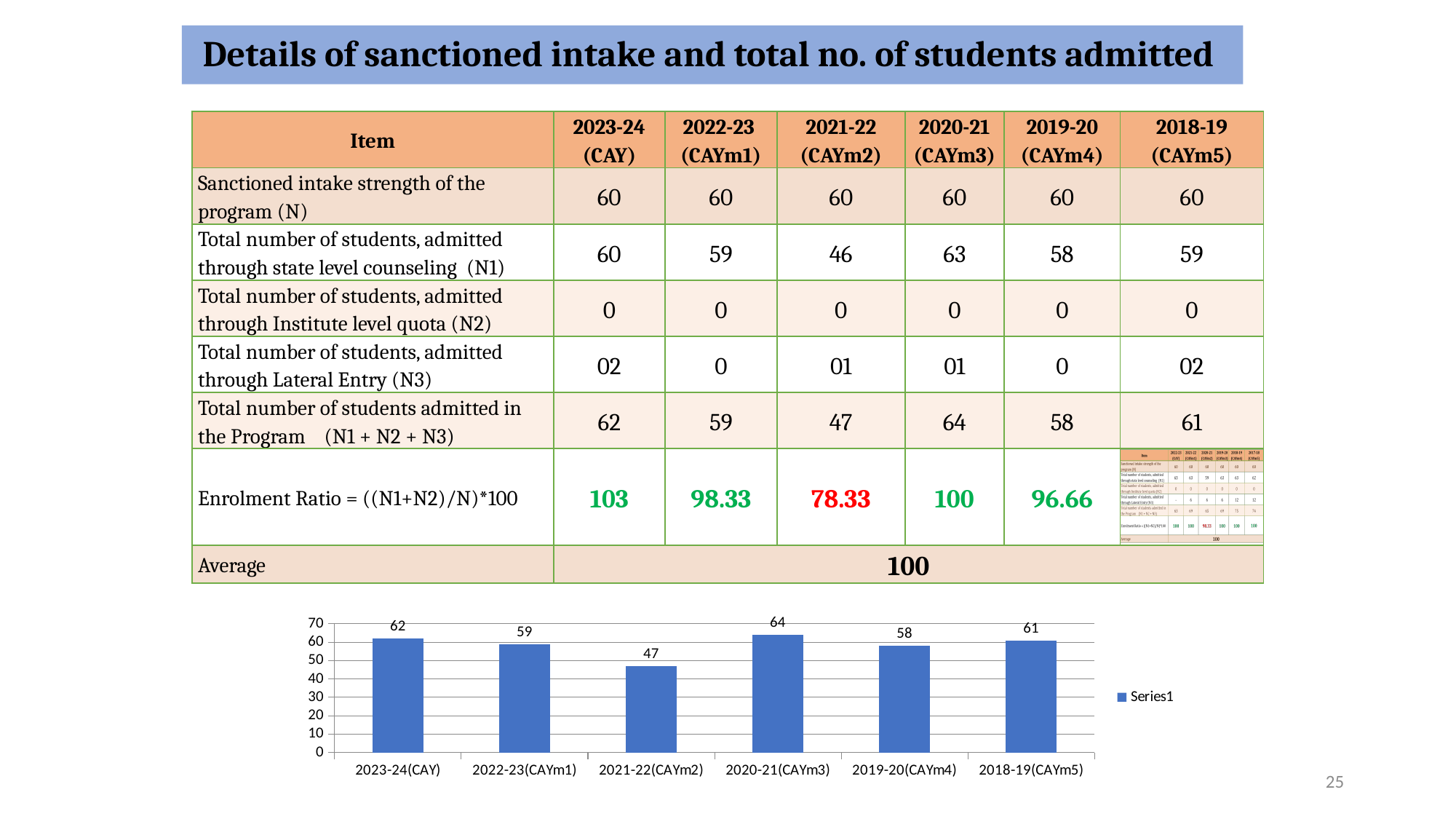
How many categories are shown on the x axis of the chart? 6 What is the value of the bar for 2019-20(CAYm4)? 58 What is the name of the series shown in the chart legend? Series1 What kind of chart is shown on the slide? bar chart Is the value for 2021-22(CAYm2) greater or less than 50? less Which category has the highest bar in the chart? 2020-21(CAYm3) How many series does the chart legend list? 1 What is the value of the bar for 2021-22(CAYm2)? 47 Which is larger, the value for 2022-23(CAYm1) or the value for 2018-19(CAYm5)? 2018-19(CAYm5) What is the value of the bar for 2023-24(CAY)? 62 Which category has the lowest bar in the chart? 2021-22(CAYm2) What is the difference between the values for 2020-21(CAYm3) and 2021-22(CAYm2)? 17